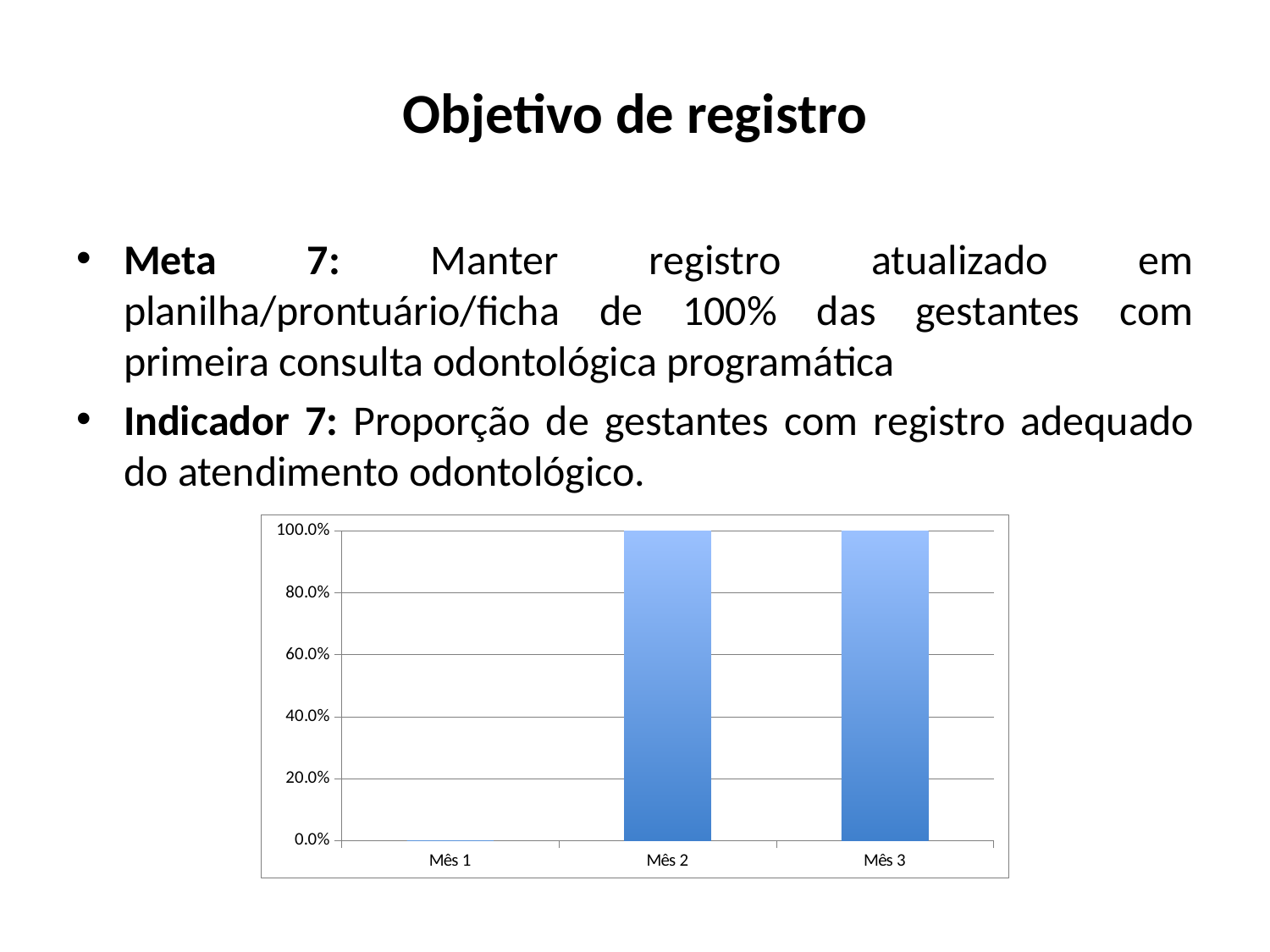
What is the value for Mês 1 in the chart? 0.0% What is the value for Mês 2 in the chart? 100.0% Is the value for Mês 3 greater or less than 80.0%? greater How many categories are shown on the x axis of the chart? 3 What is the value for Mês 3 in the chart? 100.0% What is the highest tick label shown on the vertical axis of the chart? 100.0% Which is larger in the chart, the value for Mês 1 or the value for Mês 2? Mês 2 What kind of chart is shown on the slide? bar chart Do the values rise or fall from Mês 1 to Mês 2 in the chart? rise Is the value for Mês 1 greater or less than 20.0%? less Which category has the lowest value in the chart? Mês 1 What is the difference between the value for Mês 2 and the value for Mês 1? 100.0%